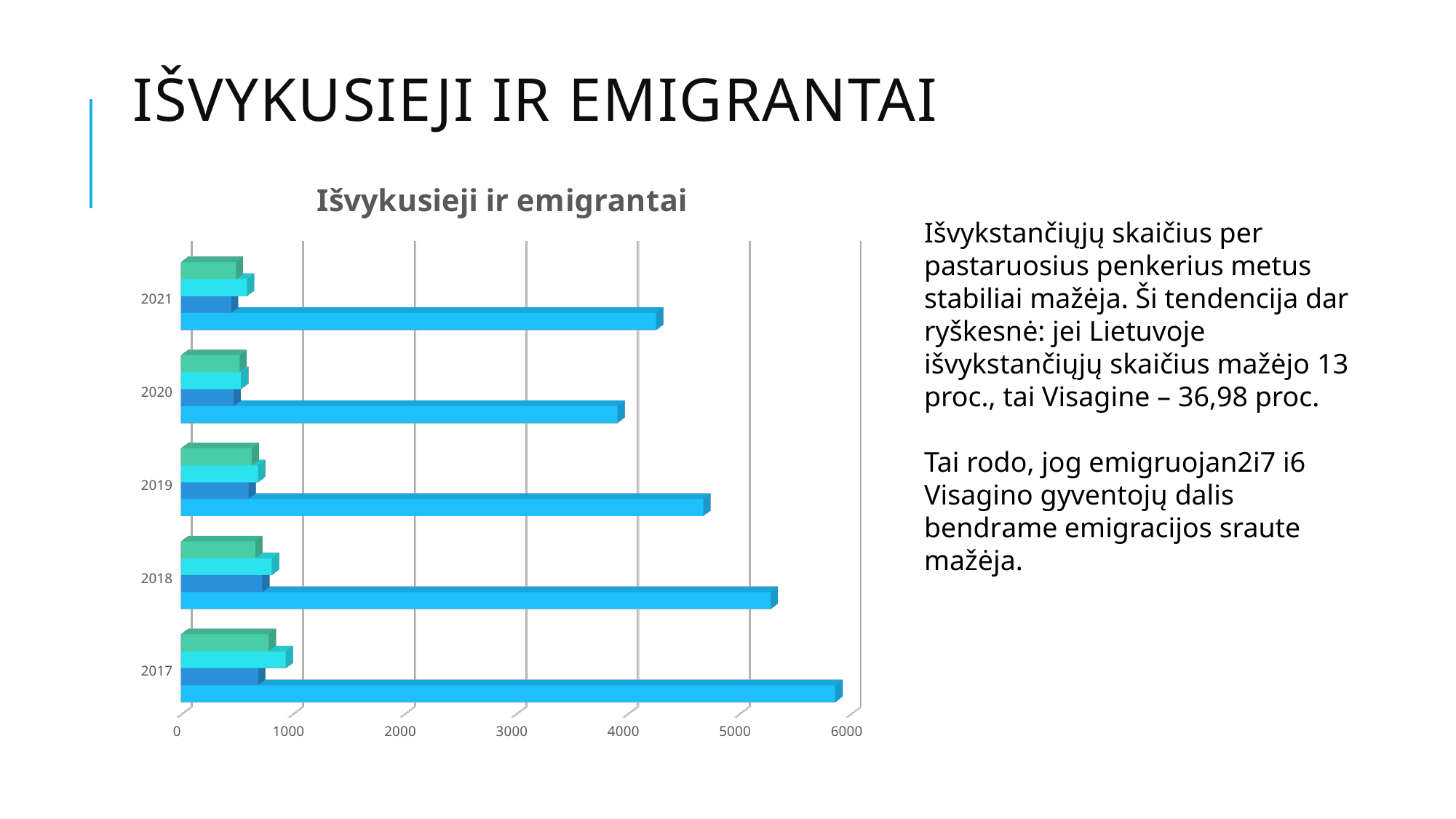
Is the longest bar for 2019 greater or less than 5000? less What is the highest value shown on the horizontal axis of the chart? 6000 Which year has the shortest longest bar (light blue series) in the chart? 2020 Which year has the longest bar in the chart? 2017 How many bars are drawn for each year in the chart? 4 What kind of chart is shown on the slide? bar chart Is the longest bar for 2018 greater or less than 5000? greater Which year has a longer light blue bar, 2018 or 2019? 2018 What is the title of the chart? Išvykusieji ir emigrantai How many years are shown on the vertical axis of the chart? 5 Is the longest bar for 2021 greater or less than 4000? greater